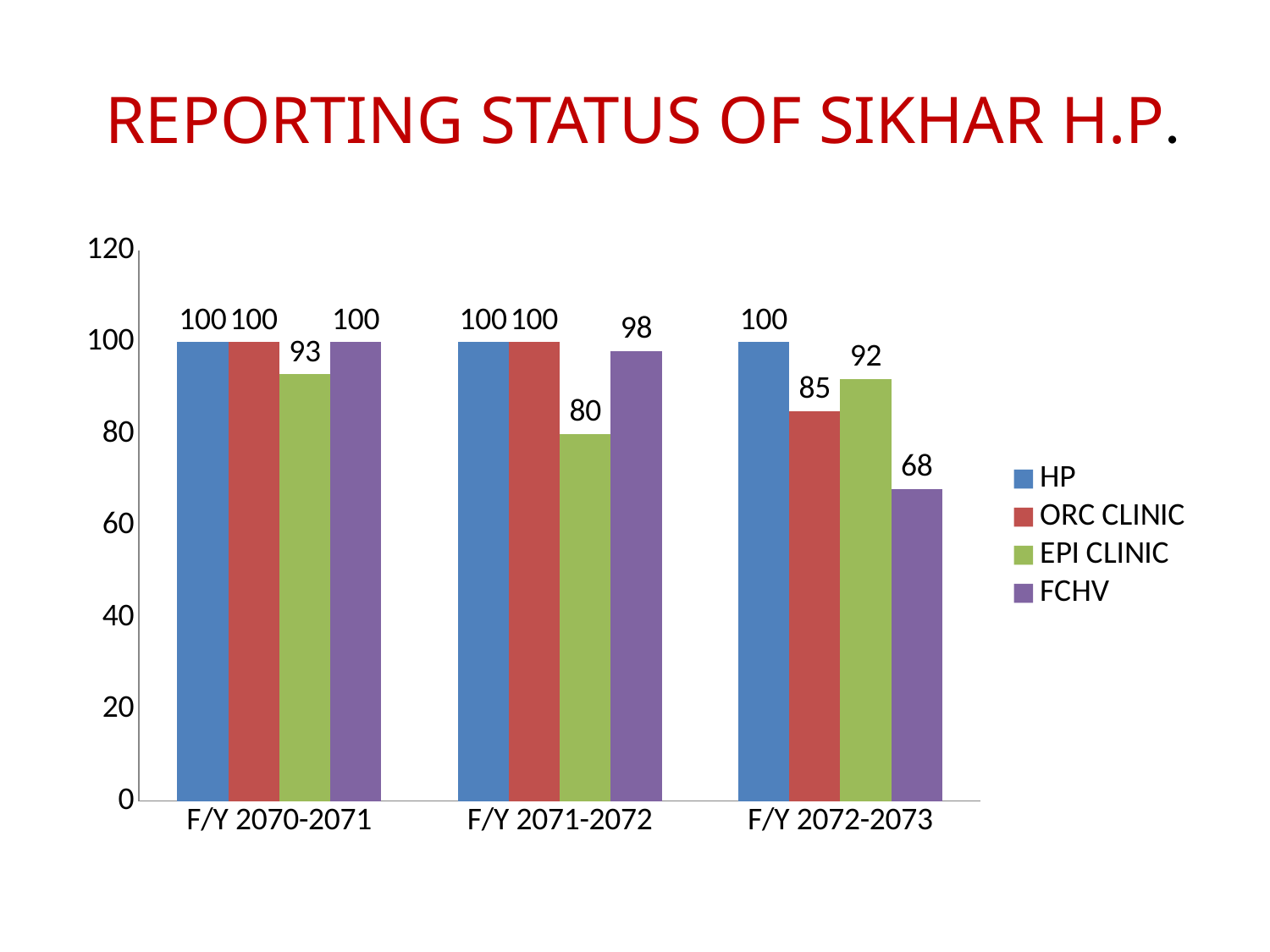
What is the value for ORC CLINIC in F/Y 2072-2073? 85 What is the value for EPI CLINIC in F/Y 2071-2072? 80 Which series has the lowest value in F/Y 2072-2073? FCHV Which is larger: EPI CLINIC in F/Y 2072-2073 or ORC CLINIC in F/Y 2072-2073? EPI CLINIC in F/Y 2072-2073 Which series has the lowest value in F/Y 2071-2072? EPI CLINIC What is the value for FCHV in F/Y 2072-2073? 68 What is the value for EPI CLINIC in F/Y 2070-2071? 93 Do the FCHV values rise or fall across the fiscal years from F/Y 2070-2071 to F/Y 2072-2073? Fall What is the difference between the FCHV values for F/Y 2071-2072 and F/Y 2072-2073? 30 What kind of chart is shown on the slide? Bar chart How many fiscal year categories are shown on the x axis? 3 How many series does the legend list? 4